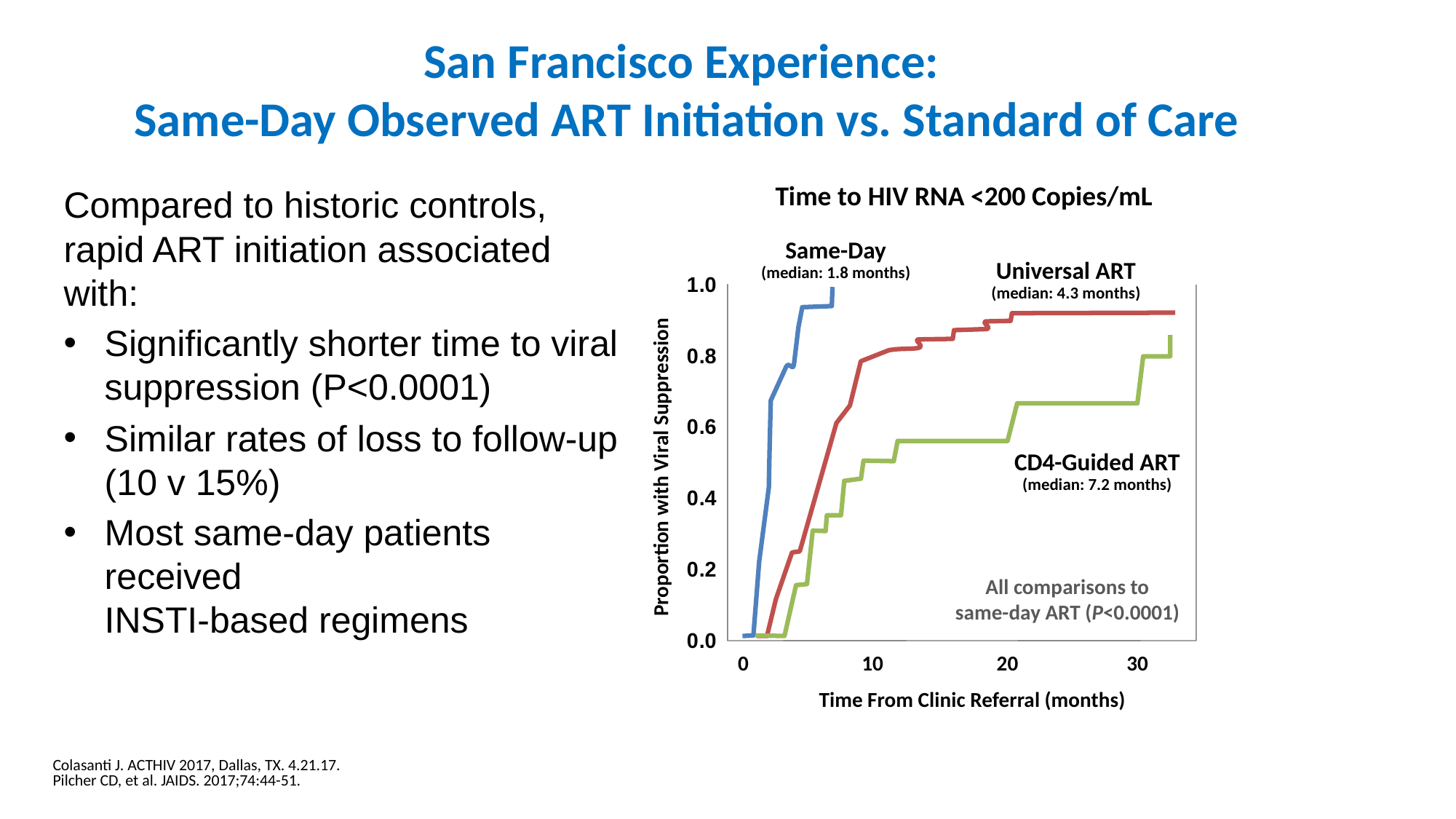
What is the median time to viral suppression for the Same-Day group? 1.8 months Which group has the shortest median time to viral suppression? Same-Day Is the proportion with viral suppression for CD4-Guided ART at 25 months greater or less than 0.8? less What is the title of the chart? Time to HIV RNA <200 Copies/mL What is the median time to viral suppression for the CD4-Guided ART group? 7.2 months What type of chart is shown on the slide? Line chart Which group has the longest median time to viral suppression? CD4-Guided ART Is the proportion with viral suppression for Universal ART at 20 months greater or less than 0.8? greater Do the curves rise or fall as time from clinic referral increases? Rise How many months longer is the median time to suppression for CD4-Guided ART than for Universal ART? 2.9 months What is the median time to viral suppression for the Universal ART group? 4.3 months How many series (treatment groups) are plotted in the chart? 3